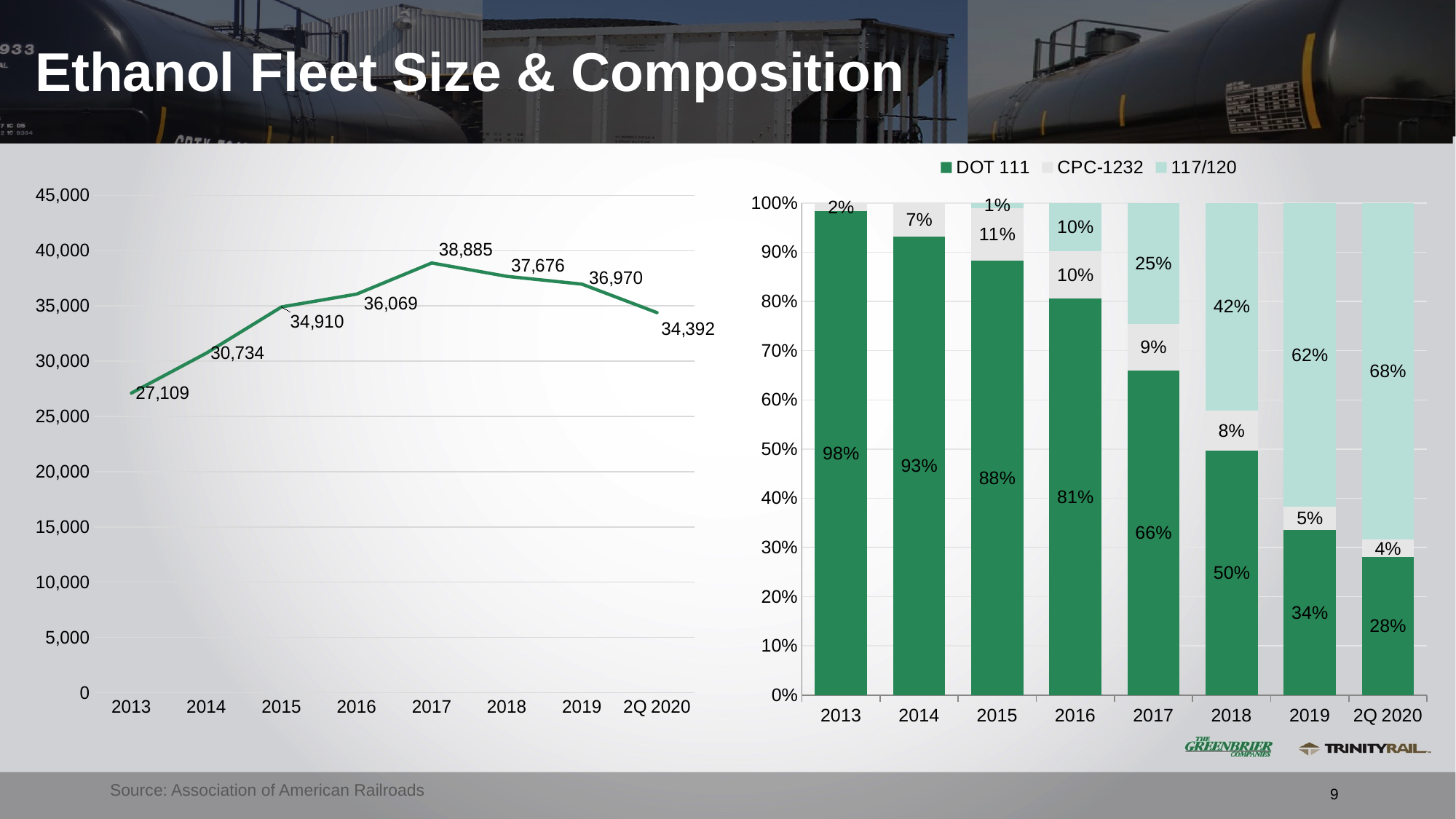
On the left chart, what is the value for 2Q 2020? 34,392 On the left chart, how many data points are plotted? 8 On the right chart, does the DOT 111 share rise or fall from 2013 to 2Q 2020? Fall On the left chart, which year has the lowest value? 2013 On the right chart, which is larger for 2017: the CPC-1232 share or the 117/120 share? 117/120 On the left chart, what is the difference between the 2017 value and the 2018 value? 1,209 On the right chart, what is the DOT 111 share for 2018? 50% On the right chart, what is the 117/120 share for 2019? 62% What kind of chart is the chart on the left? Line chart On the right chart, how many series does the legend list? 3 On the left chart, what is the value for 2017? 38,885 On the left chart, which year has the highest value? 2017